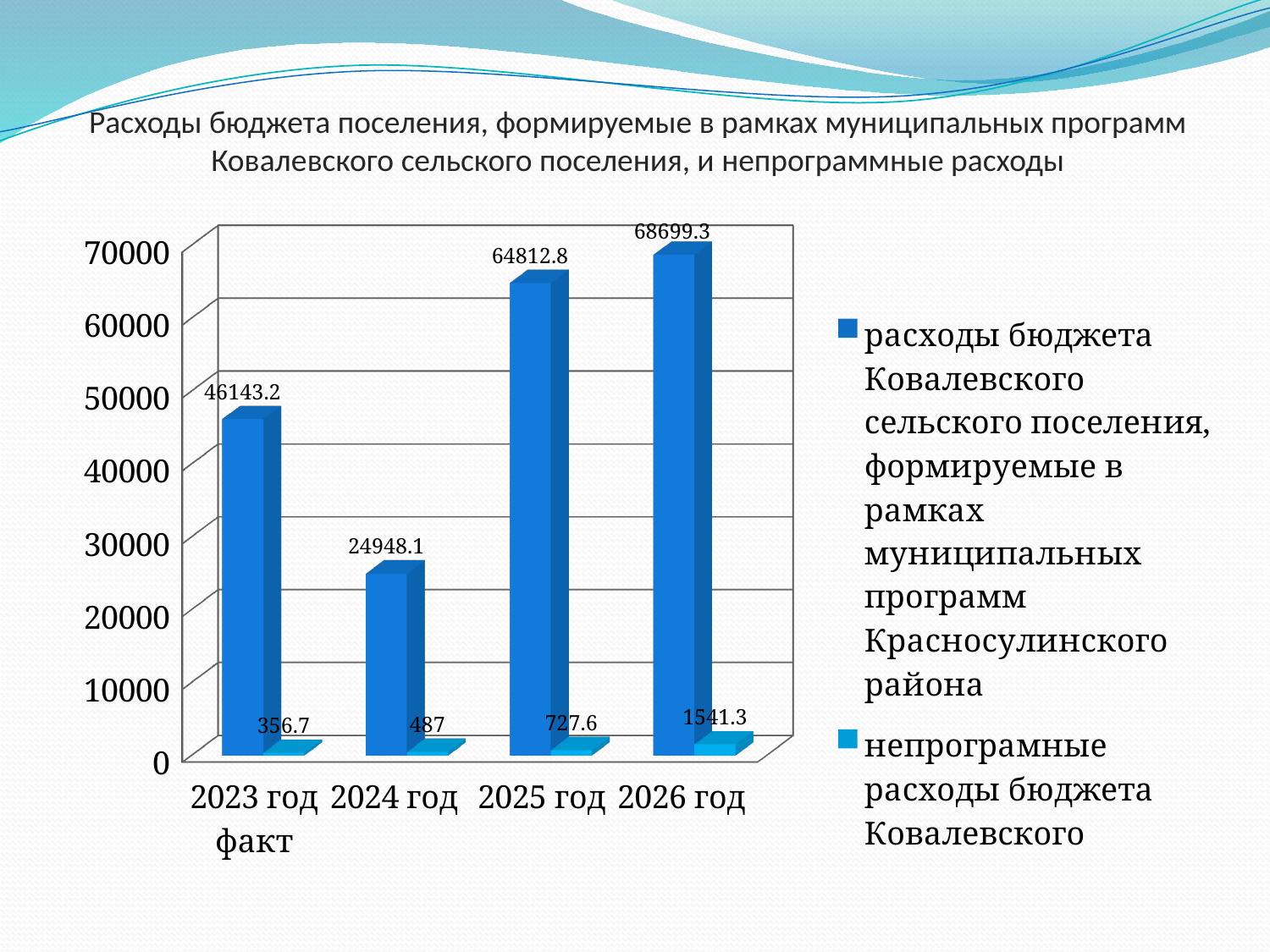
How many years (categories) are shown on the x axis? 4 What is the difference between program budget expenditures in 2026 год and 2025 год? 3886.5 Is the value of program budget expenditures for 2024 год greater or less than 30000? less What is the value of program budget expenditures (расходы бюджета, формируемые в рамках муниципальных программ) for 2025 год? 64812.8 Which is larger: program budget expenditures in 2023 год факт or in 2024 год? 2023 год факт What is the value of non-program expenditures (непрограмные расходы) for 2023 год факт? 356.7 Which year has the highest value of program budget expenditures? 2026 год Which year has the lowest value of program budget expenditures? 2024 год How many series does the legend list? 2 Do non-program expenditures (непрограмные расходы) rise or fall from 2023 год факт to 2026 год? rise What is the value of non-program expenditures (непрограмные расходы) for 2026 год? 1541.3 What kind of chart is shown on the slide? bar chart